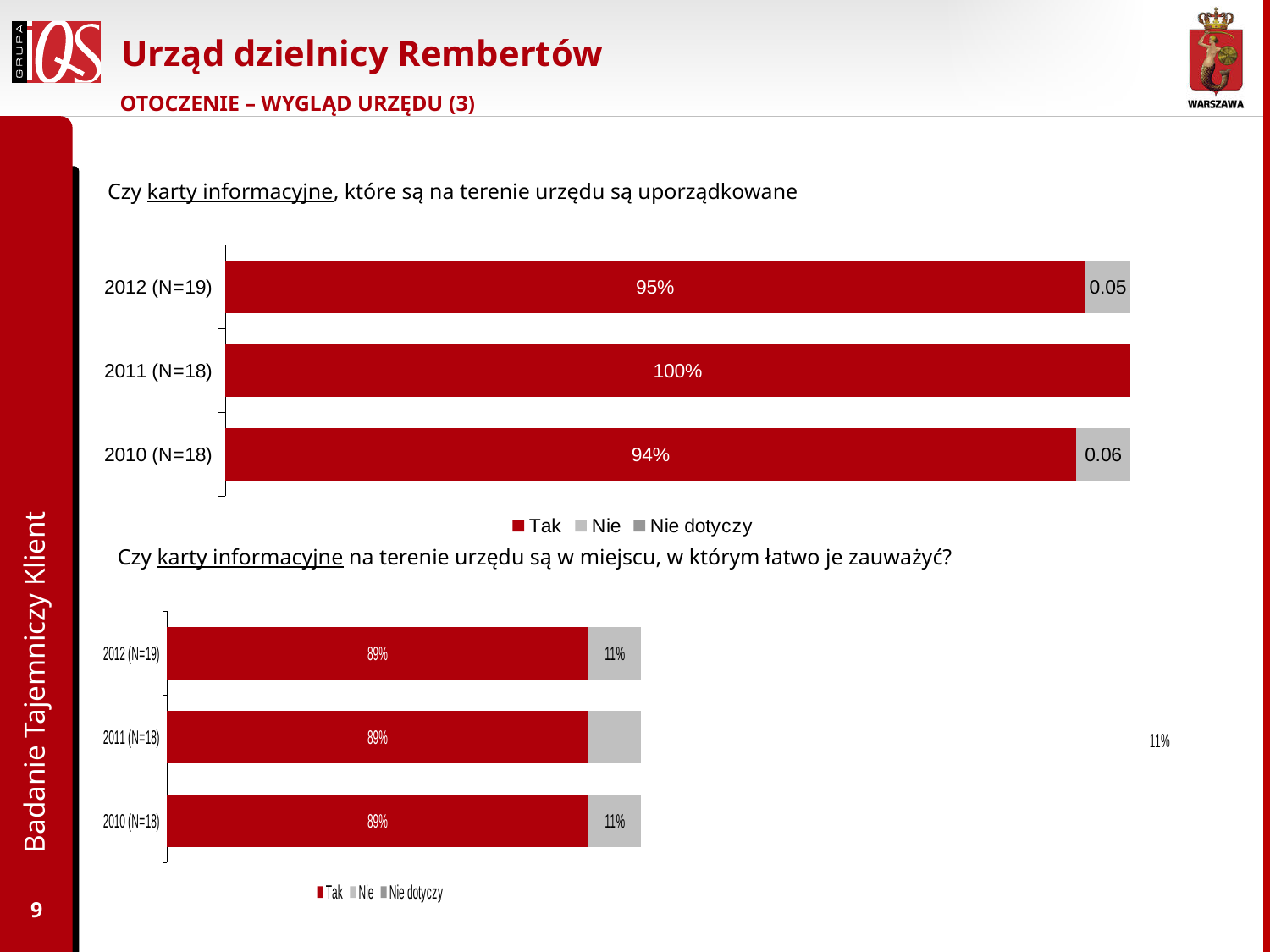
In the top chart (karty informacyjne uporządkowane), what is the difference between the 'Tak' values for 2011 (N=18) and 2010 (N=18)? 6 percentage points In the top chart (karty informacyjne uporządkowane), which year has the highest 'Tak' value? 2011 (N=18) What type of chart is the bottom chart (karty informacyjne łatwo je zauważyć)? Stacked bar chart In the top chart (karty informacyjne uporządkowane), which year has the lowest 'Tak' value? 2010 (N=18) In the bottom chart (karty informacyjne łatwo je zauważyć), what is the 'Tak' value for 2012 (N=19)? 89% In the top chart (karty informacyjne uporządkowane), what is the 'Tak' value for 2010 (N=18)? 94% In the top chart (karty informacyjne uporządkowane), what is the 'Tak' value for 2011 (N=18)? 100% In the bottom chart (karty informacyjne łatwo je zauważyć), what is the 'Tak' value for 2010 (N=18)? 89% In the bottom chart (karty informacyjne łatwo je zauważyć), what are the legend entries? Tak, Nie, Nie dotyczy In the bottom chart (karty informacyjne łatwo je zauważyć), how many year categories are shown? 3 In the top chart (karty informacyjne uporządkowane), how many series does the legend list? 3 In the top chart (karty informacyjne uporządkowane), what is the 'Tak' value for 2012 (N=19)? 95%